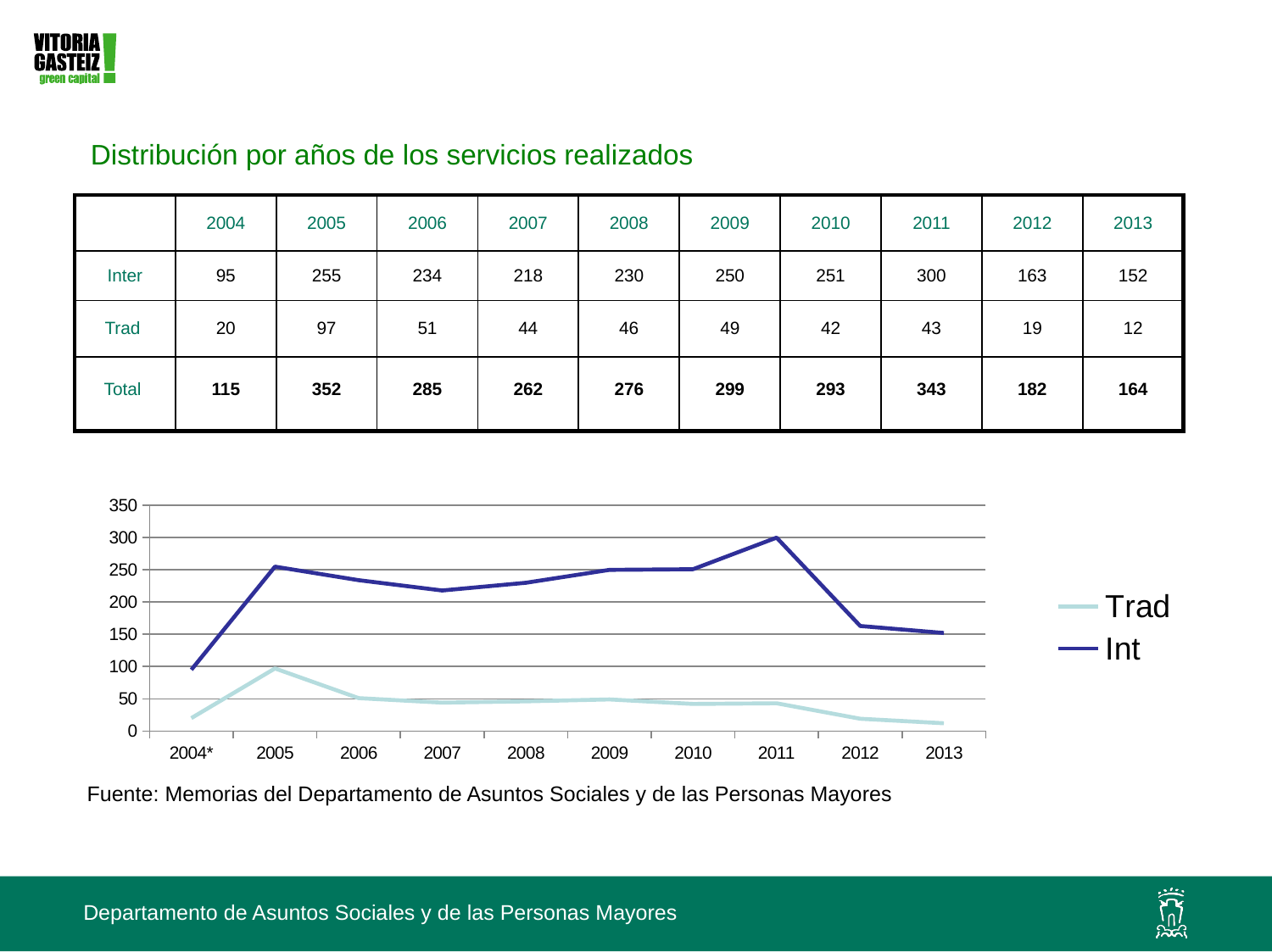
How many series does the chart legend list? 2 Is the value for Trad in 2005 greater or less than 50? greater In which year does the Int series reach its highest value? 2011 According to the table, what is the Trad value for 2005? 97 Does the Int series rise or fall from 2011 to 2013? fall What is the difference between the Inter value in 2011 and the Inter value in 2013 in the table? 148 According to the table, what is the Inter value for 2011? 300 Is the value for Int in 2011 greater or less than 250? greater In 2008, which series has the larger value, Int or Trad? Int How many years are plotted along the x axis of the chart? 10 What kind of chart is shown on the slide? line chart In which year is the Trad series at its lowest? 2013